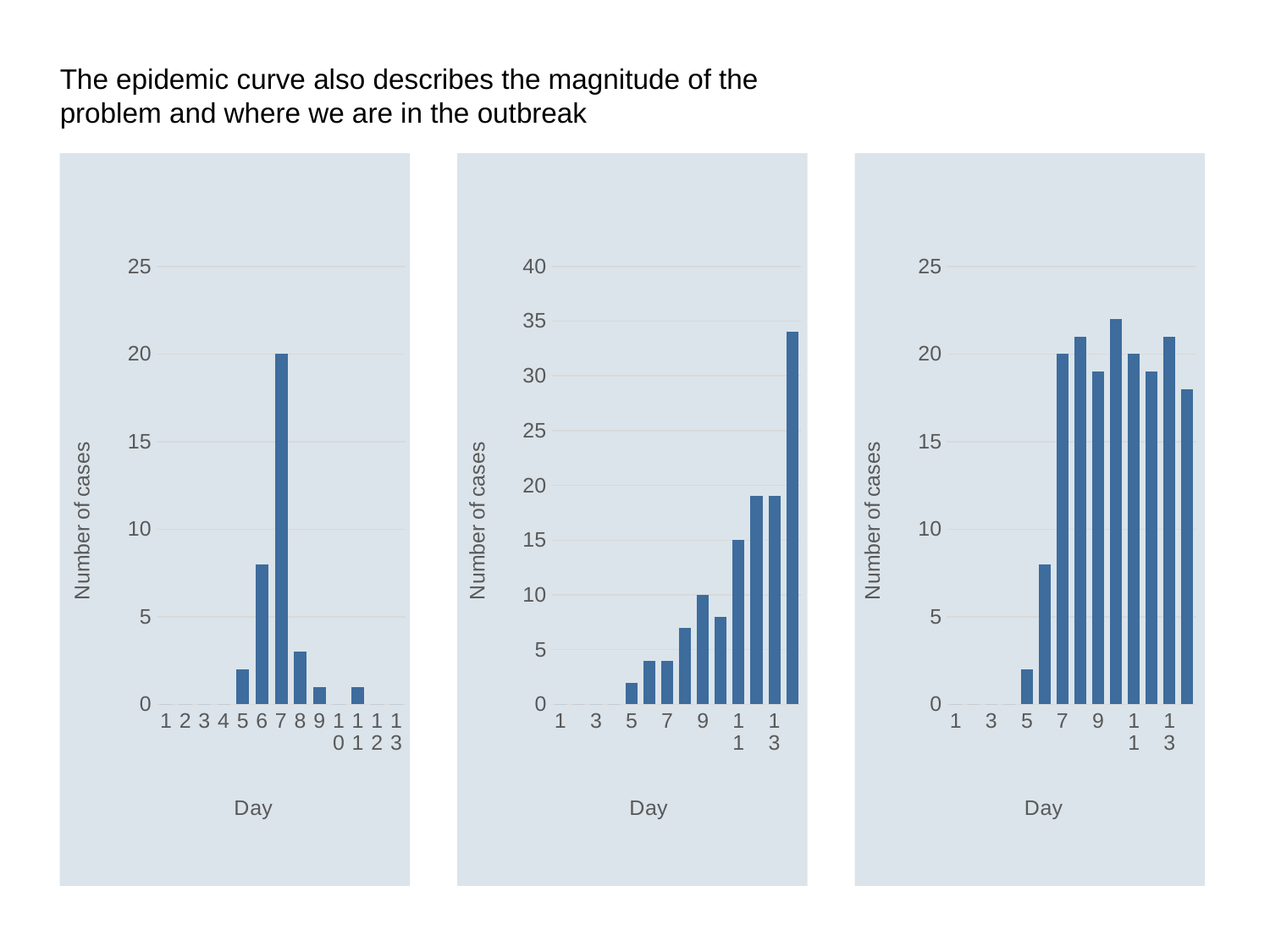
In the right chart, what is the number of cases on day 7? 20 In the middle chart, do the values generally rise or fall from left to right along the x axis? rise In the left chart, which is larger, the value for day 6 or the value for day 8? Day 6 In the middle chart, what is the number of cases on day 9? 10 How many days are labelled on the x axis of the left chart? 13 In the middle chart, is the value of the rightmost bar greater or less than 30? greater In the middle chart, what is the number of cases on day 11? 15 What kind of chart is the left chart on the slide? bar chart In the left chart, what is the number of cases on day 7? 20 In the left chart, is the value for day 6 greater or less than 5? greater What is the label on the y axis of the right chart? Number of cases In the left chart, which day has the highest number of cases? Day 7